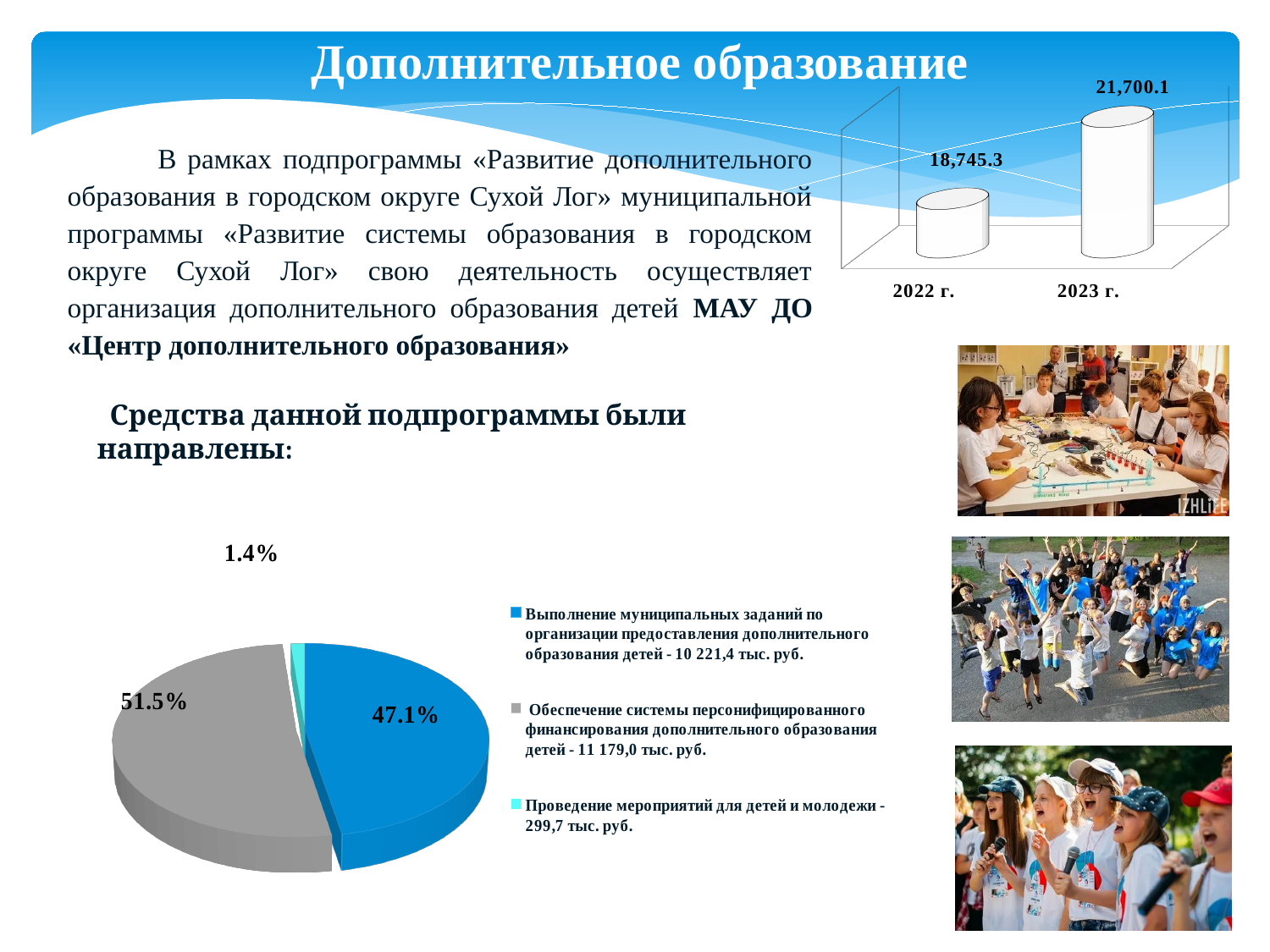
In the bar chart at the top right, what is the value for 2023 г.? 21,700.1 In the bar chart at the top right, what is the value for 2022 г.? 18,745.3 In the bar chart at the top right, do the values rise or fall from 2022 г. to 2023 г.? rise In the pie chart at the bottom left, which category has the smallest slice? Проведение мероприятий для детей и молодежи What kind of chart is shown at the top right of the slide? bar chart In the pie chart at the bottom left, what share does the slice for «Выполнение муниципальных заданий по организации предоставления дополнительного образования детей» have? 47.1% In the bar chart at the top right, what is the difference between the 2023 г. and 2022 г. values? 2,954.8 In the pie chart at the bottom left, what share does the slice for «Обеспечение системы персонифицированного финансирования дополнительного образования детей» have? 51.5% What kind of chart is shown at the bottom left of the slide? pie chart In the pie chart at the bottom left, what amount does the legend give for «Проведение мероприятий для детей и молодежи»? 299,7 тыс. руб. In the bar chart at the top right, which year has the higher value? 2023 г. How many entries does the legend of the pie chart at the bottom left list? 3